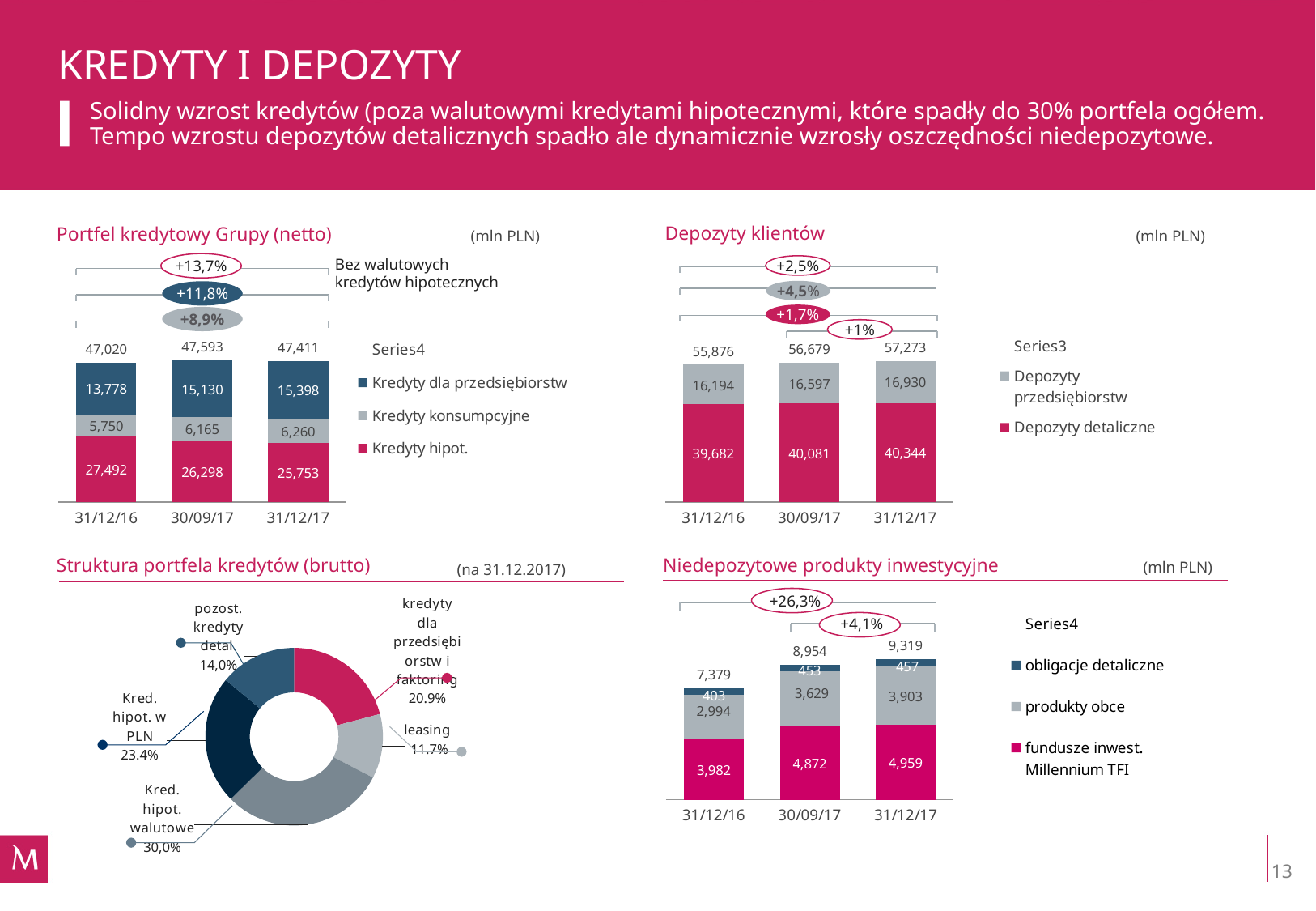
What kind of chart is 'Struktura portfela kredytów (brutto)'? Donut (pie) chart In the 'Niedepozytowe produkty inwestycyjne' chart, which is larger: produkty obce at 30/09/17 or at 31/12/17? 31/12/17 In the 'Depozyty klientów' chart, how many series does the legend list (excluding Series3)? 2 In the 'Depozyty klientów' chart, do total deposits rise or fall from 31/12/16 to 31/12/17? rise In the 'Portfel kredytowy Grupy (netto)' chart, what is the value of Kredyty hipot. at 31/12/17? 25,753 In the 'Depozyty klientów' chart, what is the value of Depozyty detaliczne at 30/09/17? 40,081 In the 'Portfel kredytowy Grupy (netto)' chart, what is the total of the stacked bar for 30/09/17? 47,593 In the 'Depozyty klientów' chart, which date has the highest total deposits? 31/12/17 In the 'Portfel kredytowy Grupy (netto)' chart, what is the difference between Kredyty dla przedsiębiorstw at 31/12/17 and at 31/12/16? 1,620 In the 'Struktura portfela kredytów (brutto)' chart, which segment has the largest share? Kred. hipot. walutowe In the 'Niedepozytowe produkty inwestycyjne' chart, what is the value of fundusze inwest. Millennium TFI at 31/12/16? 3,982 In the 'Struktura portfela kredytów (brutto)' chart, what share does leasing have? 11.7%